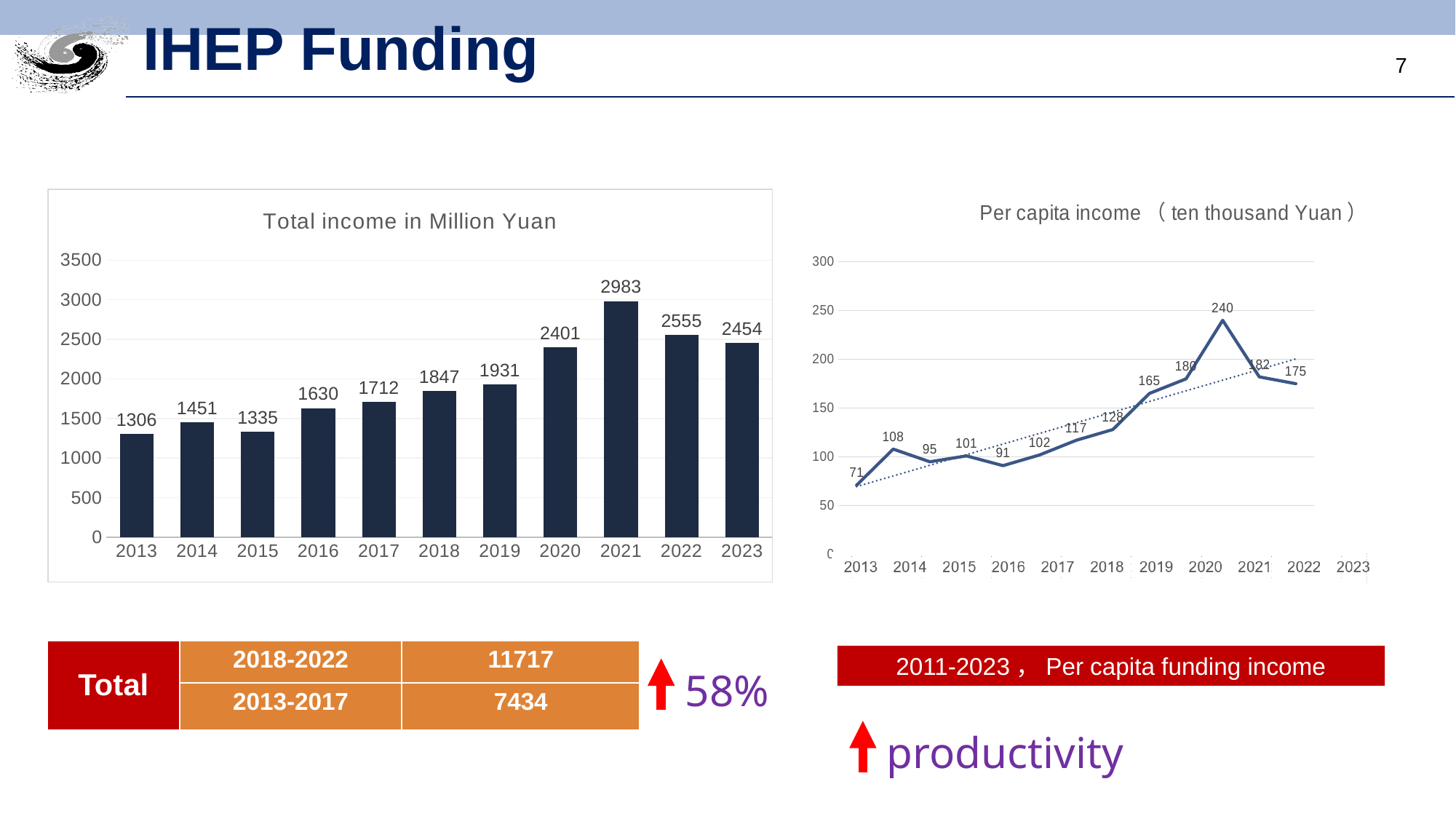
In the 'Per capita income' chart, what is the highest labelled value on the line? 240 In the 'Total income in Million Yuan' chart, what is the difference between the values for 2022 and 2023? 101 How many years are shown in the 'Total income in Million Yuan' chart? 11 In the 'Total income in Million Yuan' chart, which is larger, the value for 2014 or the value for 2015? 2014 In the 'Total income in Million Yuan' chart, what is the value for 2013? 1306 What kind of chart is the 'Per capita income' chart on the right? line chart In the 'Total income in Million Yuan' chart, which year has the lowest total income? 2013 In the 'Total income in Million Yuan' chart, what is the value for 2020? 2401 What kind of chart is the 'Total income in Million Yuan' chart? bar chart In the 'Total income in Million Yuan' chart, which year has the highest total income? 2021 In the 'Total income in Million Yuan' chart, what is the value for 2021? 2983 In the 'Per capita income' chart, what is the lowest labelled value on the line? 71